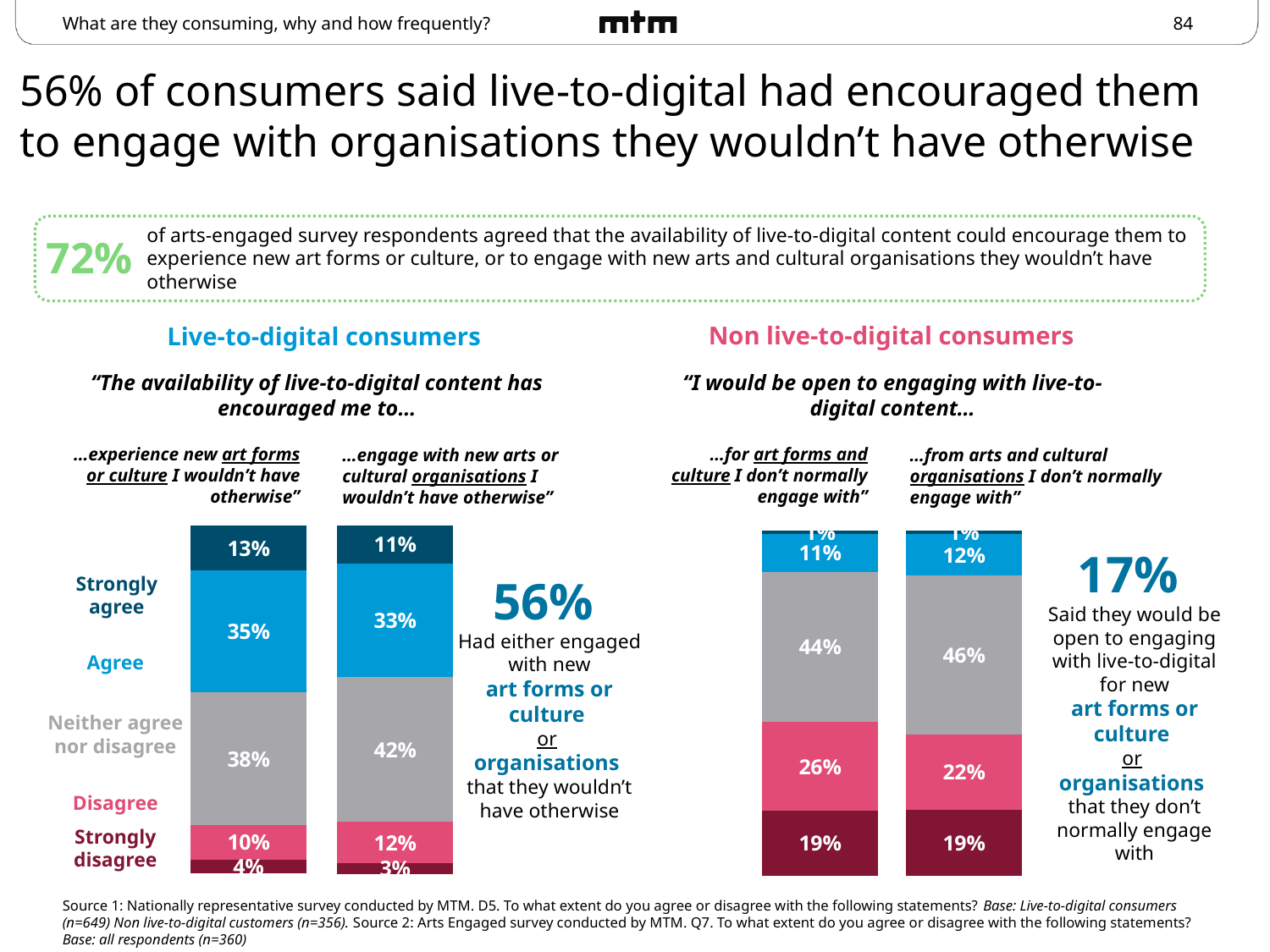
In the Non live-to-digital consumers chart, what percentage disagree that they would be open to engaging with live-to-digital content for art forms and culture they don't normally engage with? 26% In the Non live-to-digital consumers chart, what percentage strongly disagree for the 'from arts and cultural organisations I don't normally engage with' statement? 19% In the Live-to-digital consumers chart, which response category is the largest for the 'experience new art forms or culture' statement? Neither agree nor disagree In the Non live-to-digital consumers chart, what percentage neither agree nor disagree for the 'organisations' statement? 46% In the Live-to-digital consumers chart, what percentage neither agree nor disagree for the 'engage with new arts or cultural organisations' statement? 42% In the Non live-to-digital consumers chart, what is the difference between the 'Neither agree nor disagree' percentages for the organisations bar and the art forms and culture bar? 2% What type of chart is used to show the responses on this slide? Stacked bar chart In the Live-to-digital consumers chart, what percentage of respondents strongly agree that live-to-digital content has encouraged them to experience new art forms or culture? 13% In the Non live-to-digital consumers chart, which bar has the higher 'Disagree' percentage: art forms and culture, or organisations? Art forms and culture In the Live-to-digital consumers chart, what percentage agree that live-to-digital content has encouraged them to engage with new arts or cultural organisations? 33% How many response categories are listed alongside the Live-to-digital consumers chart? 5 In the Live-to-digital consumers chart, what is the difference between the 'Agree' percentages for the art forms or culture bar and the organisations bar? 2%